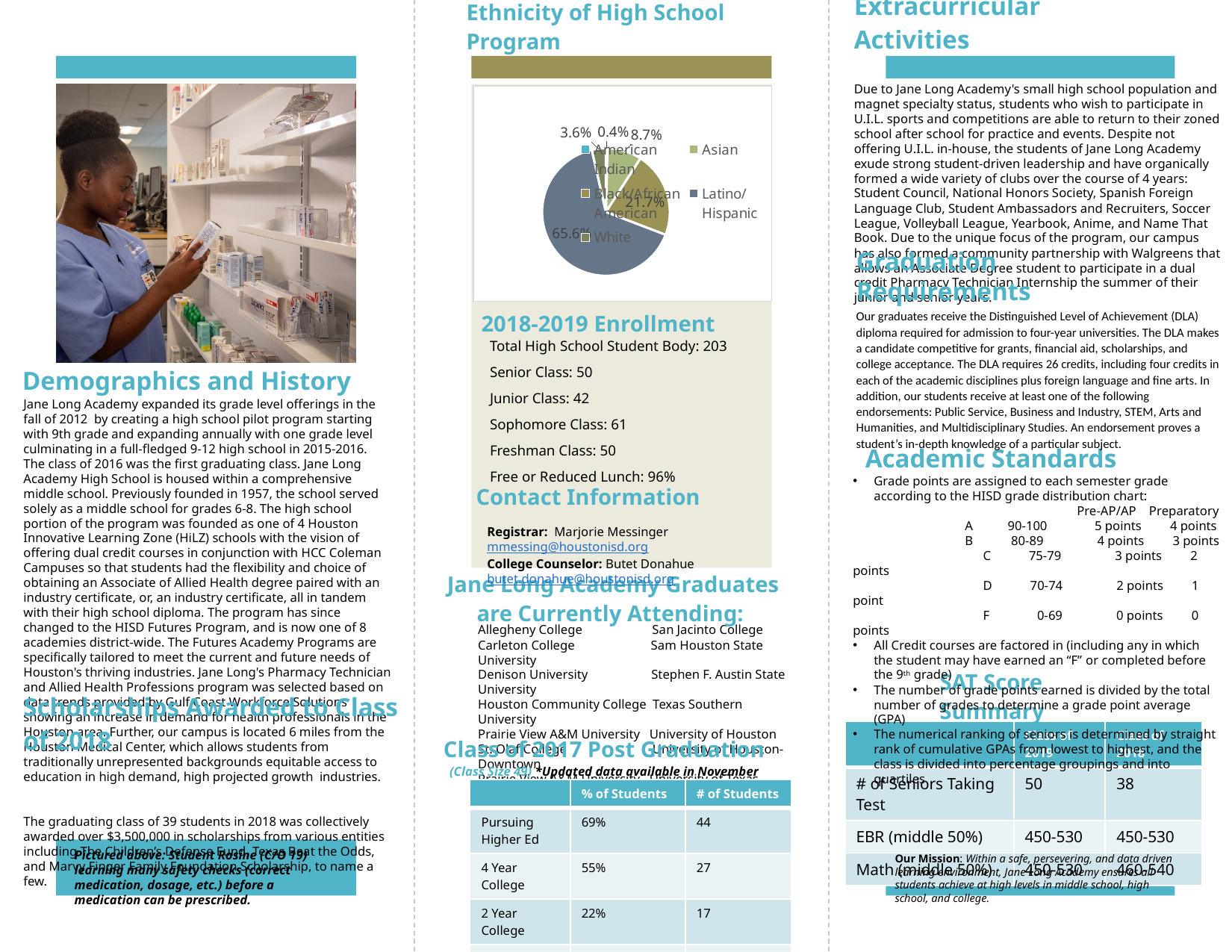
Which ethnicity has the largest slice in the "Ethnicity of High School Program" pie chart? Latino/Hispanic How many ethnicity categories does the legend of the "Ethnicity of High School Program" pie chart list? 5 In the "Ethnicity of High School Program" pie chart, what is the combined share of Latino/Hispanic and Black/African American? 87.3% What is the smallest percentage shown on the "Ethnicity of High School Program" pie chart? 0.4% In the "Ethnicity of High School Program" pie chart, what share is Black/African American? 21.7% In the "Ethnicity of High School Program" pie chart, what share is Latino/Hispanic? 65.6% In the "Ethnicity of High School Program" pie chart, is the Latino/Hispanic share greater or less than 50%? greater What is the title of the pie chart on the slide? Ethnicity of High School Program In the "Ethnicity of High School Program" pie chart, which is larger: the Asian slice or the Black/African American slice? Black/African American What kind of chart is the "Ethnicity of High School Program" chart? pie chart In the "Ethnicity of High School Program" pie chart, what share is Asian? 8.7% In the "Ethnicity of High School Program" pie chart, how many percentage points larger is the Latino/Hispanic share than the Black/African American share? 43.9%